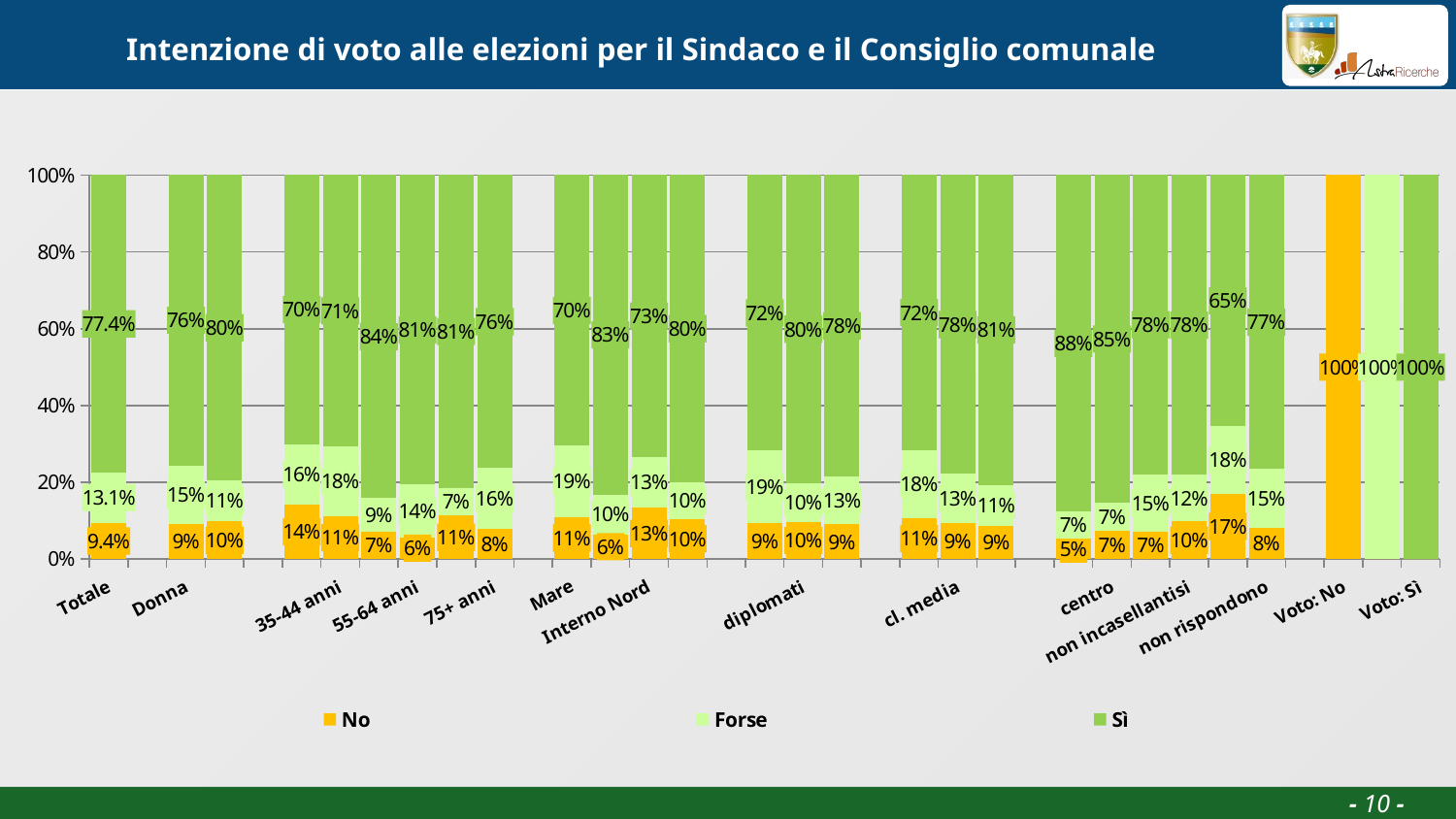
What is the value of Sì for the Voto: Sì bar? 100% How many series does the legend list? 3 What is the value of No for the Voto: No bar? 100% What is the title of the slide? Intenzione di voto alle elezioni per il Sindaco e il Consiglio comunale What is the value of Forse for the Totale bar? 13.1% In the Totale bar, which series has the largest share? Sì What are the three series named in the legend? No, Forse, Sì What is the value of Sì for the Totale bar? 77.4% What is the value of No for the Totale bar? 9.4% In the Totale bar, which is larger, Forse or No? Forse What kind of chart is shown on the slide? Stacked bar chart In the Totale bar, what is the difference between the Forse value and the No value? 3.7%